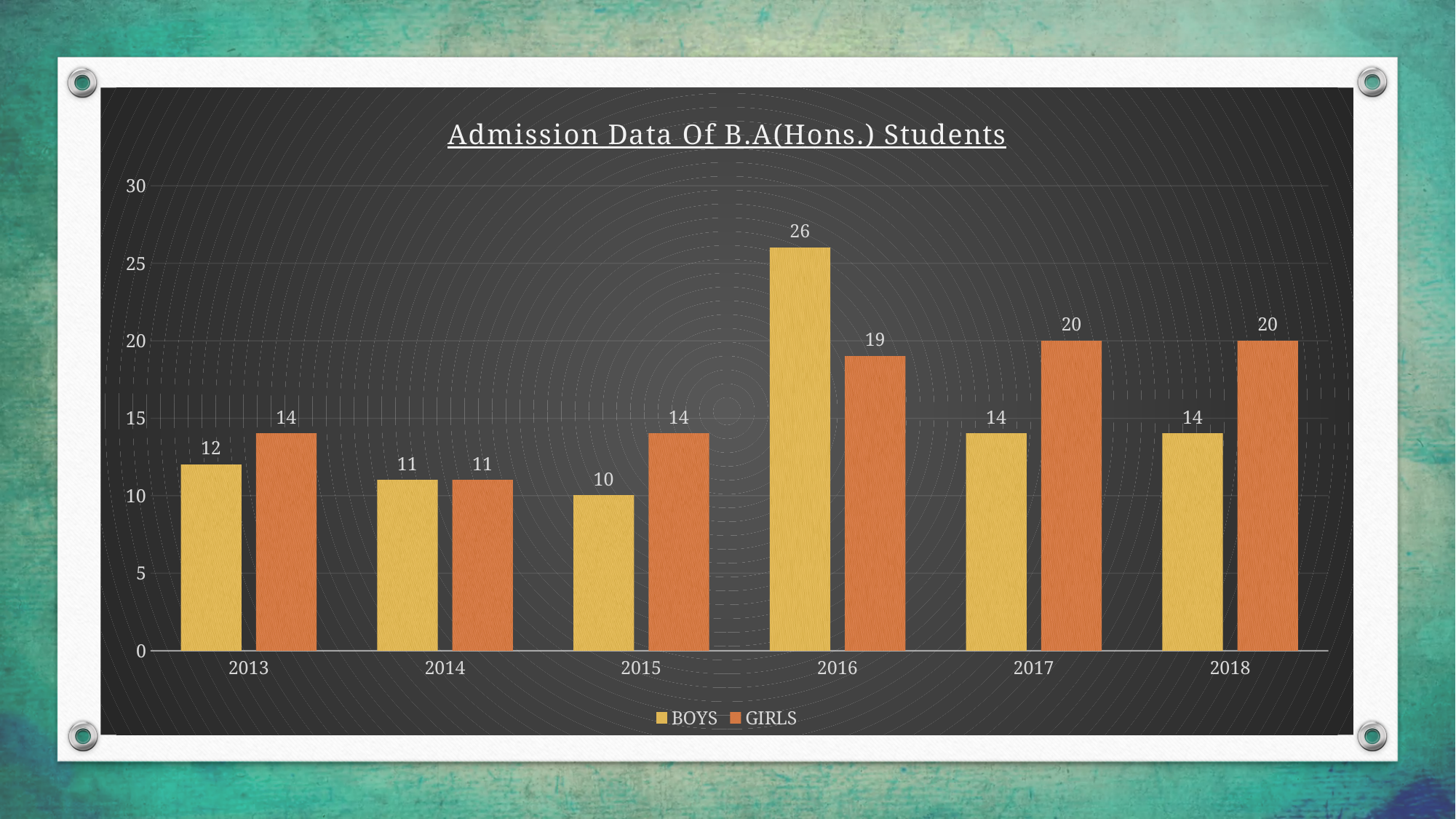
What is the difference between BOYS and GIRLS in 2016? 7 What kind of chart is shown on the slide? bar chart What is the value for GIRLS in 2013? 14 How many years are shown on the x axis? 6 Which is larger in 2017, BOYS or GIRLS? GIRLS How many series does the legend list? 2 Which year has the highest value for BOYS? 2016 What is the value for BOYS in 2015? 10 What is the value for BOYS in 2016? 26 Is the value for BOYS in 2016 greater or less than 25? greater Which year has the lowest value for GIRLS? 2014 Which year has the lowest value for BOYS? 2015